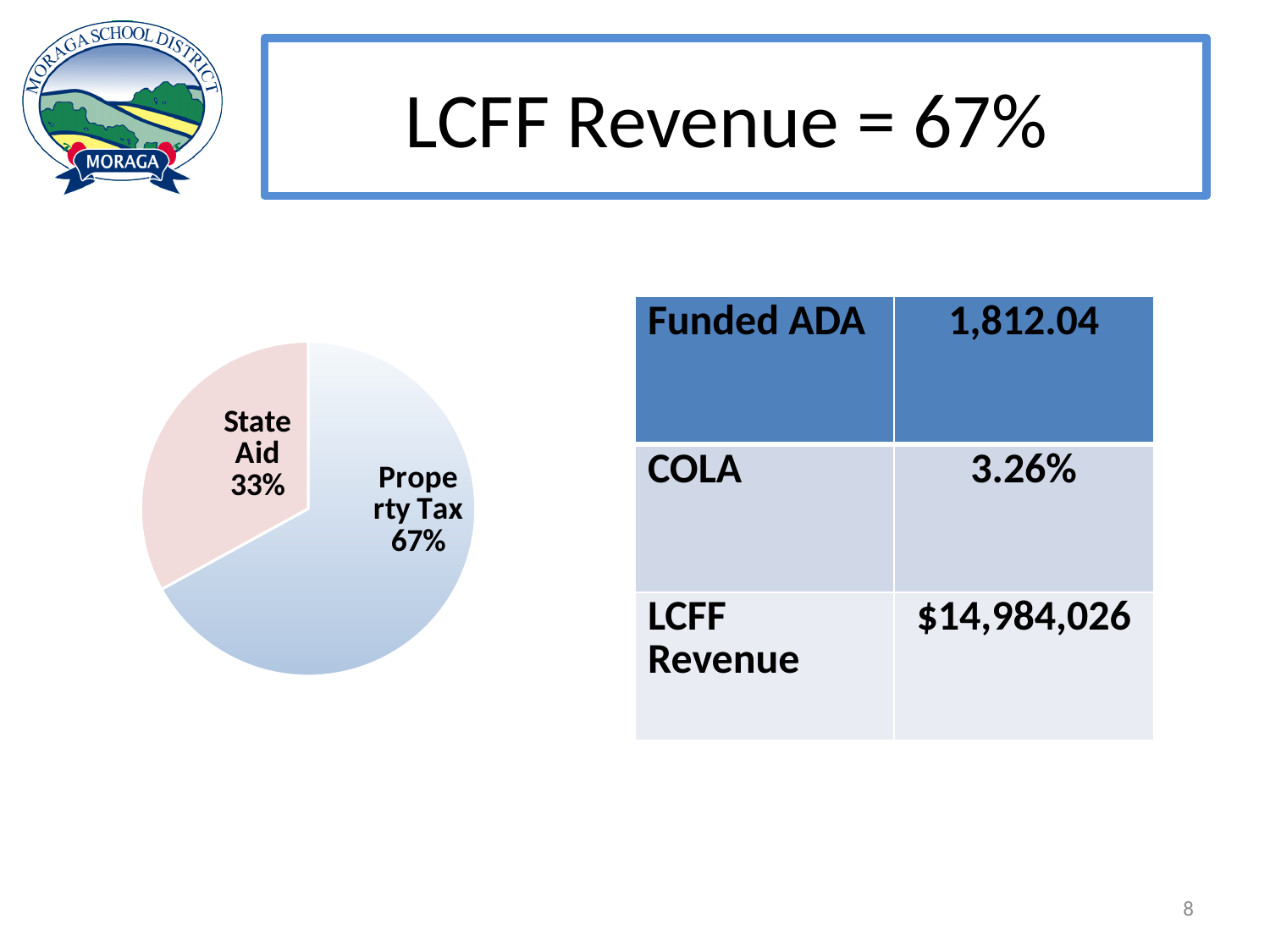
What share of the pie does State Aid represent? 33% Which is larger, the Property Tax slice or the State Aid slice? Property Tax What share of the pie does Property Tax represent? 67% Is the share for State Aid greater or less than 50%? less What is the difference in percentage points between the Property Tax slice and the State Aid slice? 34 Which slice of the pie is the largest? Property Tax What kind of chart is shown on the slide? Pie chart How many slices does the pie chart have? 2 What colour is the State Aid slice of the pie chart? Pink What is the title shown above the pie chart on the slide? LCFF Revenue = 67% Which slice of the pie is the smallest? State Aid